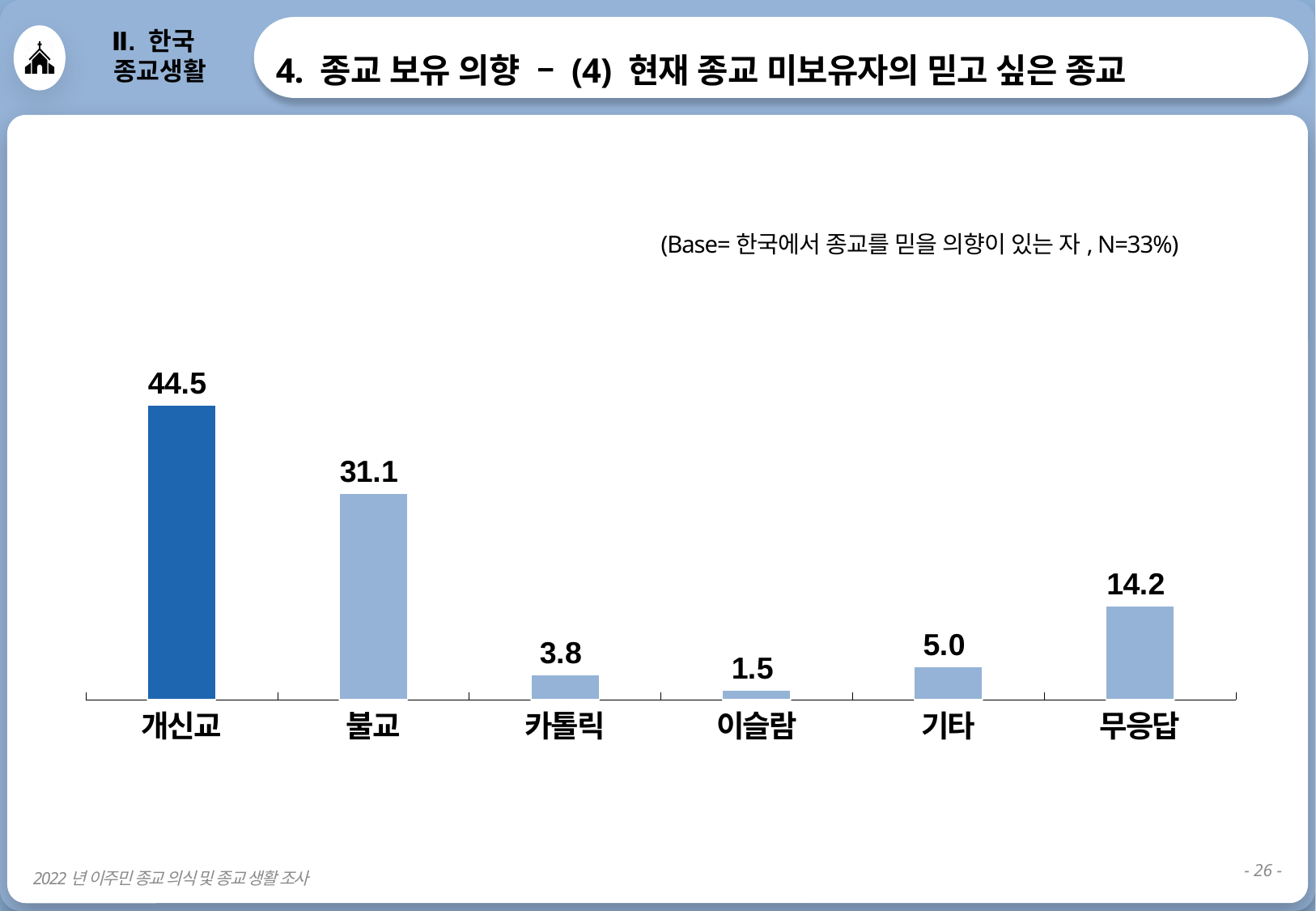
What is the value for 카톨릭? 3.8 What is the value for 불교? 31.1 Which category has the highest value? 개신교 What is the value for 개신교? 44.5 What is the value for 무응답? 14.2 What is the difference between the values for 개신교 and 불교? 13.4 What kind of chart is shown on the slide? bar chart Which is larger, the value for 기타 or the value for 카톨릭? 기타 Which category has the lowest value? 이슬람 What is the base (N) stated above the chart? N=33% How many categories are shown on the x axis? 6 What is the value for 이슬람? 1.5